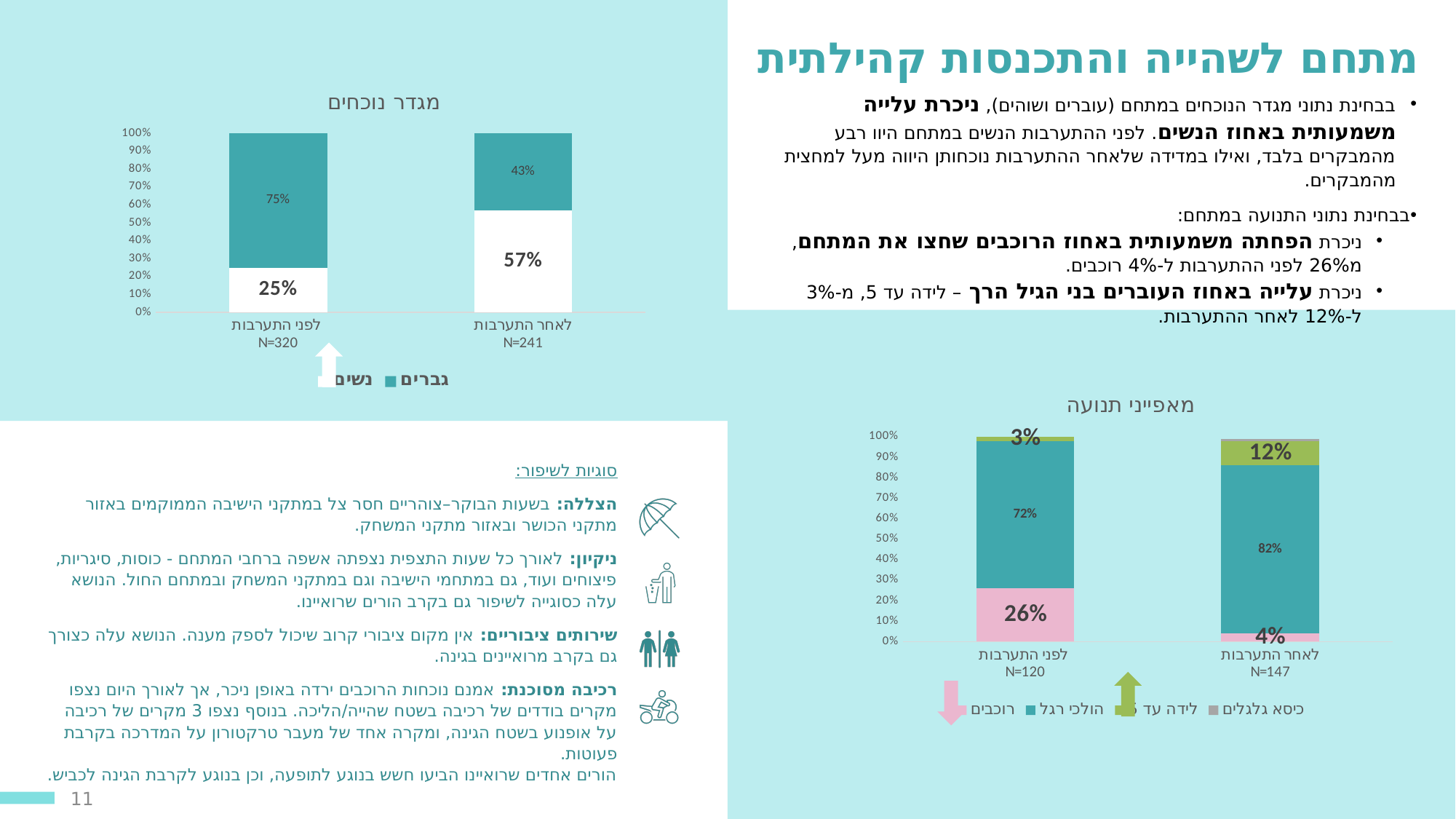
What kind of chart is the chart titled 'מאפייני תנועה'? Stacked bar chart In the chart titled 'מאפייני תנועה', what is the value for הולכי רגל in the 'לאחר התערבות' bar? 82% In the chart titled 'מגדר נוכחים', which is larger: the נשים value for 'לפני התערבות' or for 'לאחר התערבות'? לאחר התערבות In the chart titled 'מאפייני תנועה', what is the difference between the רוכבים value before the intervention (לפני התערבות) and after (לאחר התערבות)? 22% In the chart titled 'מגדר נוכחים', what is the value for גברים in the 'לאחר התערבות' bar? 43% In the chart titled 'מאפייני תנועה', what is the N value shown for the 'לאחר התערבות' category? N=147 In the chart titled 'מגדר נוכחים', how many series does the legend list? 2 In the chart titled 'מאפייני תנועה', how many series does the legend list? 4 In the chart titled 'מאפייני תנועה', what is the value for רוכבים in the 'לפני התערבות' bar? 26% In the chart titled 'מגדר נוכחים', what is the value for נשים in the 'לפני התערבות' bar? 25% In the chart titled 'מאפייני תנועה', what is the value for לידה עד 5 in the 'לאחר התערבות' bar? 12% In the chart titled 'מגדר נוכחים', what is the difference between the גברים value before the intervention (לפני התערבות) and after (לאחר התערבות)? 32%